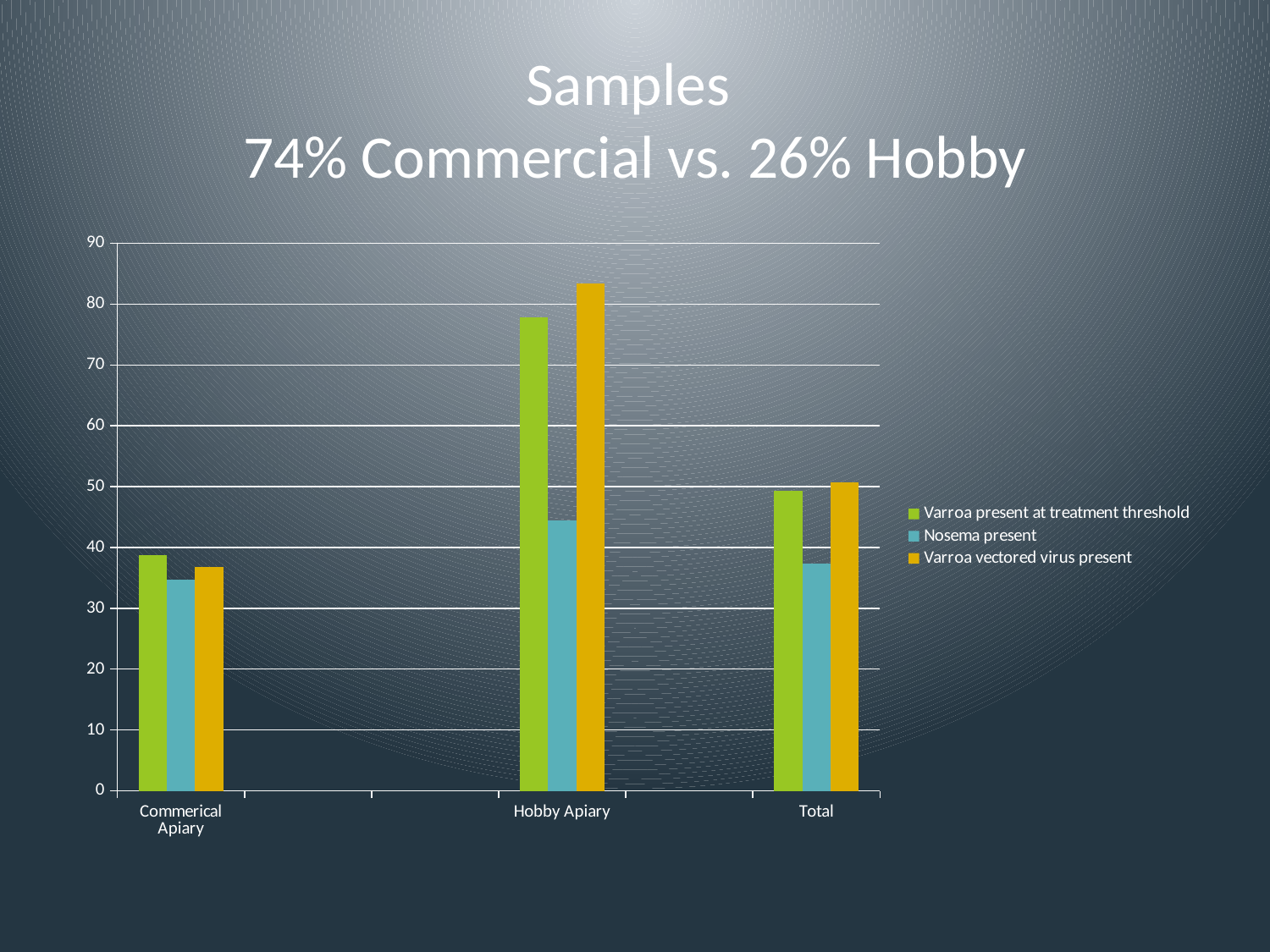
What kind of chart is shown on the slide? bar chart In the Total category, is the value for Varroa present at treatment threshold larger or smaller than the value for Nosema present? larger What is the title of the slide above the chart? Samples 74% Commercial vs. 26% Hobby Is the value for Nosema present in the Commerical Apiary category greater or less than 40? less Is the value for Varroa vectored virus present in the Hobby Apiary category greater or less than 80? greater Which category has the highest value for the Nosema present series? Hobby Apiary Is the value for Varroa present at treatment threshold in the Hobby Apiary category greater or less than 70? greater Which bar is the tallest in the whole chart? Varroa vectored virus present for Hobby Apiary How many series does the chart's legend list? 3 Within the Hobby Apiary category, which series has the lowest bar? Nosema present How many categories are shown on the x axis of the chart? 3 Is the Varroa vectored virus present value larger for Hobby Apiary or for Commerical Apiary? Hobby Apiary